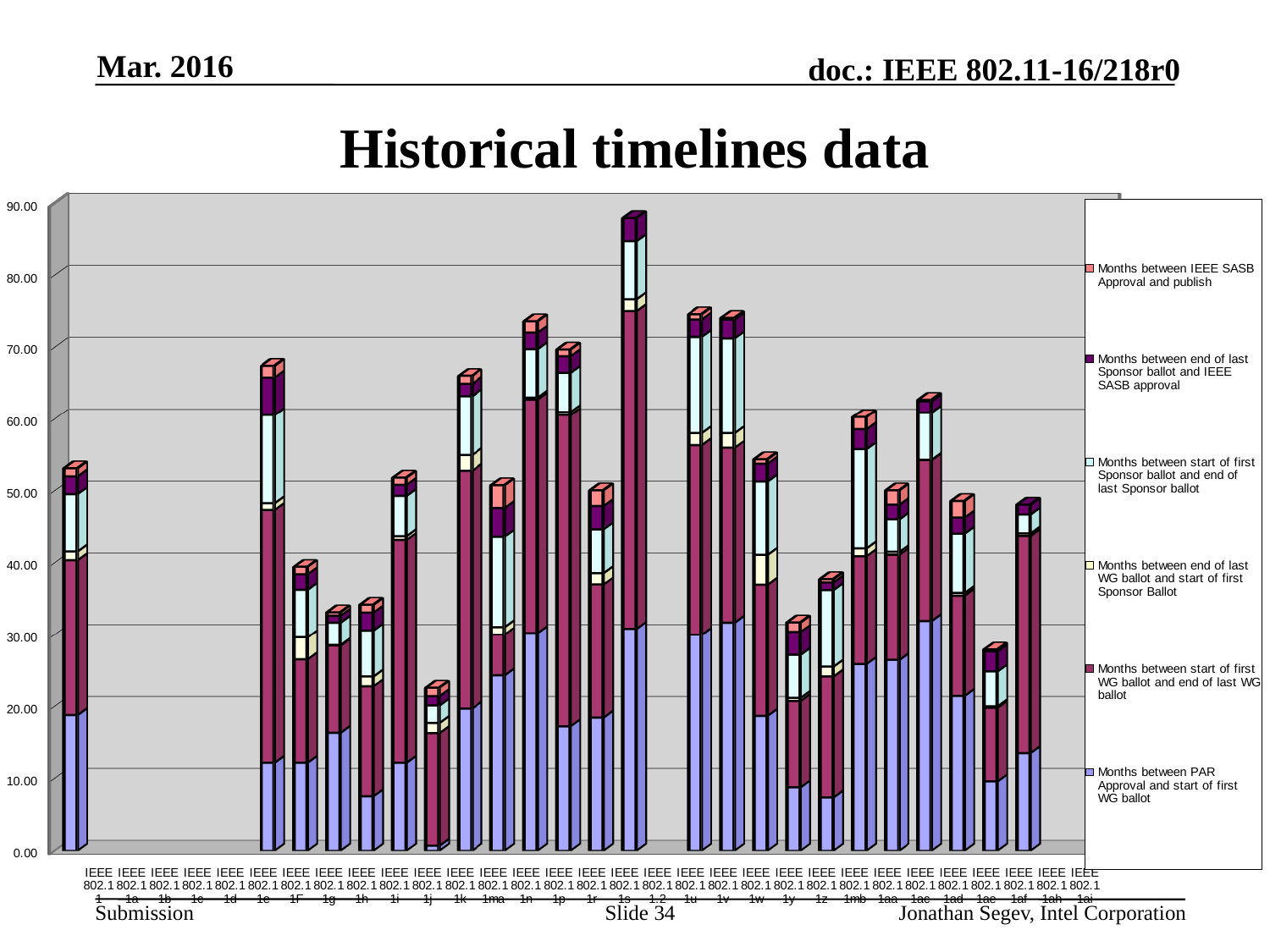
Which series is shown at the bottom of each stacked bar? Months between PAR Approval and start of first WG ballot Among the categories with plotted bars, which has the shortest stacked bar? IEEE 802.1 1j Is the total value for IEEE 802.1 1j greater or less than 30? less What is the first (top) entry in the chart legend? Months between IEEE SASB Approval and publish Which category has the tallest stacked bar? IEEE 802.1 1s How many series does the legend list? 6 Which has the taller stacked bar, IEEE 802.1 1n or IEEE 802.1 1w? IEEE 802.1 1n Is the total value for IEEE 802.1 1s greater or less than 80? greater Is the total value for IEEE 802.1 1e greater or less than 60? greater Which has the taller stacked bar, IEEE 802.1 1e or IEEE 802.1 1f? IEEE 802.1 1e What kind of chart is shown on the slide? Stacked bar chart